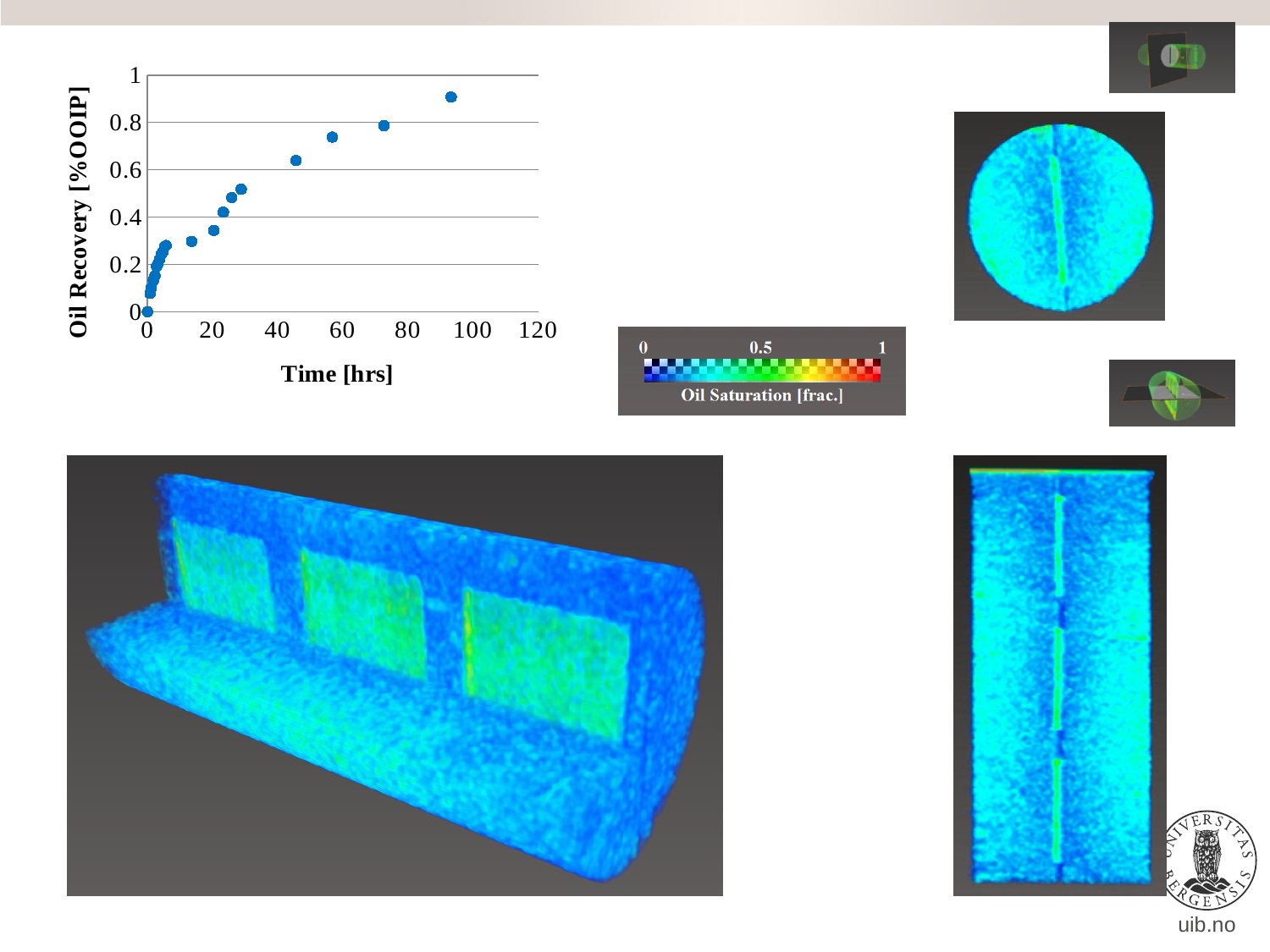
Is the oil recovery at the first plotted point after time 0 greater or less than 0.2? less What is the label of the x-axis of the chart? Time [hrs] Do the oil recovery values rise or fall as time increases along the x-axis? rise Is the oil recovery at the point plotted near 57 hrs greater or less than 0.6? greater Does the highest oil recovery occur at the earliest or the latest plotted time? latest Is the oil recovery at the last plotted point (around 93 hrs) greater or less than 0.8? greater What is the label of the y-axis of the chart? Oil Recovery [%OOIP] What kind of chart is shown on the slide? scatter chart What is the maximum value shown on the x-axis of the chart? 120 Is the oil recovery at the point plotted near 93 hrs larger or smaller than the oil recovery at the point near 45 hrs? larger